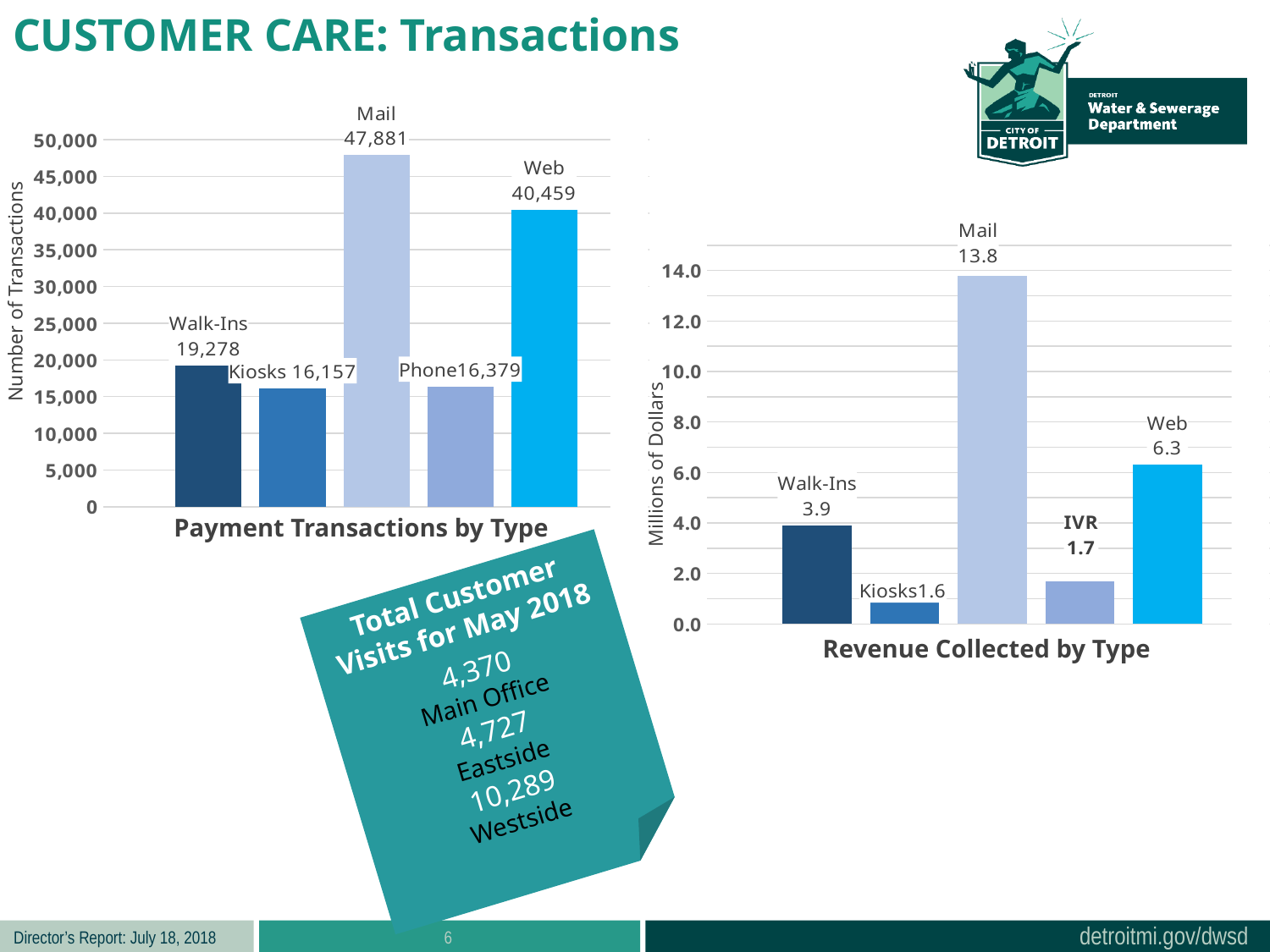
In the Revenue Collected by Type chart, which type collected the most revenue? Mail In the Payment Transactions by Type chart, what is the difference between Mail and Web transactions? 7,422 In the Payment Transactions by Type chart, which payment type has the highest number of transactions? Mail In the Payment Transactions by Type chart, which payment type has the lowest number of transactions? Kiosks In the Revenue Collected by Type chart, what is the difference between Web and Walk-Ins revenue? 2.4 In the Revenue Collected by Type chart, how many millions of dollars were collected by Mail? 13.8 In the Payment Transactions by Type chart, how many transactions were made by Mail? 47,881 In the Revenue Collected by Type chart, which is larger, revenue from Walk-Ins or from Web? Web In the Revenue Collected by Type chart, how much revenue was collected via IVR? 1.7 In the Payment Transactions by Type chart, how many transactions were Walk-Ins? 19,278 What kind of chart is the Revenue Collected by Type chart? Bar chart In the Payment Transactions by Type chart, how many payment types are shown? 5